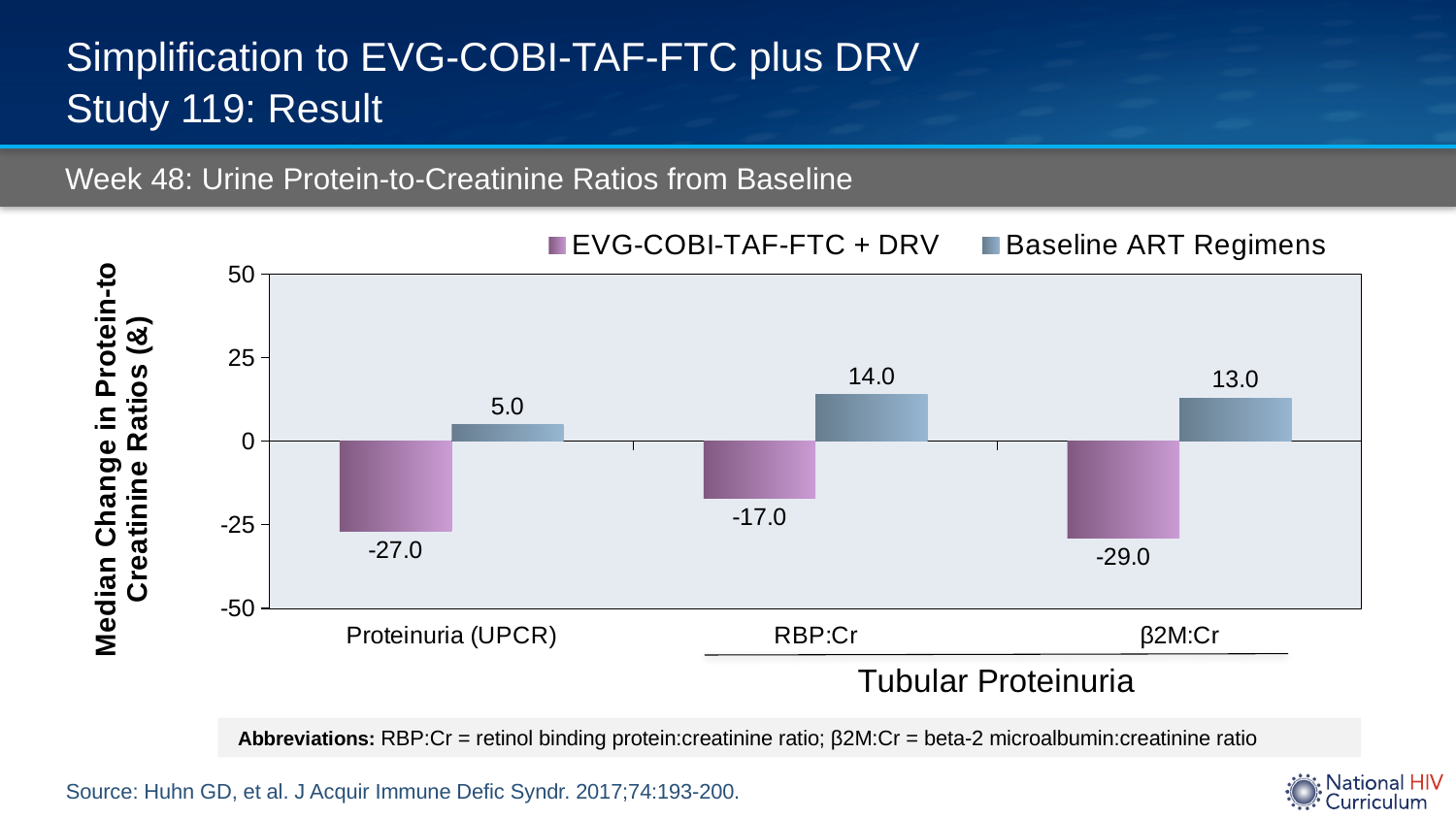
For β2M:Cr, which group has the larger value: EVG-COBI-TAF-FTC + DRV or Baseline ART Regimens? Baseline ART Regimens What is the difference between the Baseline ART Regimens value and the EVG-COBI-TAF-FTC + DRV value for RBP:Cr? 31.0 What kind of chart is shown on the slide? Bar chart What is the median change in protein-to-creatinine ratio for Proteinuria (UPCR) in the EVG-COBI-TAF-FTC + DRV group? -27.0 How many categories are shown on the x axis of the chart? 3 What is the value for Proteinuria (UPCR) in the Baseline ART Regimens group? 5.0 How many series does the legend list? 2 Which category has the highest value in the Baseline ART Regimens series? RBP:Cr What is the value for RBP:Cr in the Baseline ART Regimens group? 14.0 Is the value for Proteinuria (UPCR) in the EVG-COBI-TAF-FTC + DRV group greater or less than -25? less Which category has the lowest value in the EVG-COBI-TAF-FTC + DRV series? β2M:Cr What is the value for β2M:Cr in the EVG-COBI-TAF-FTC + DRV group? -29.0